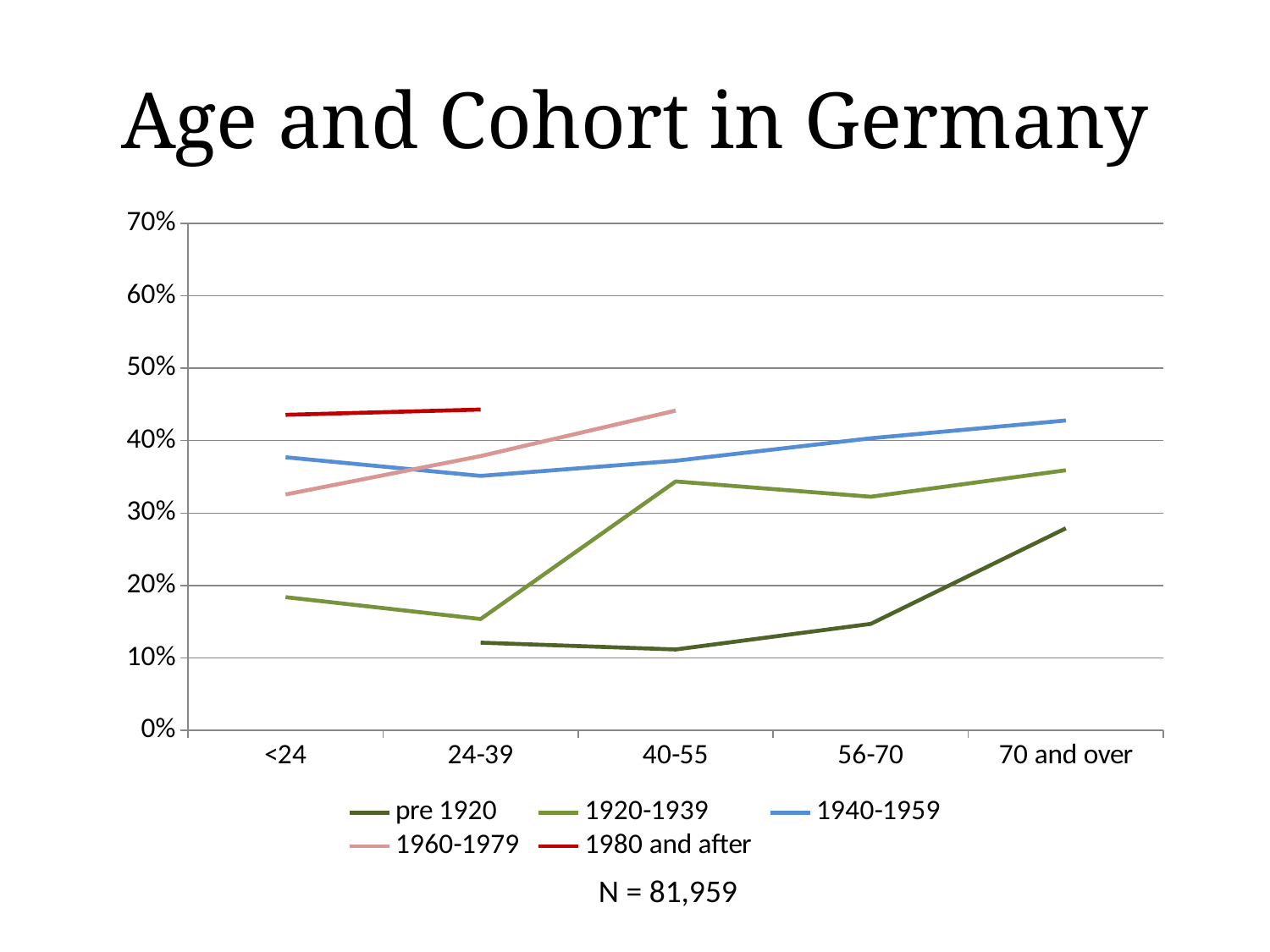
What sample size (N) is stated below the chart? N = 81,959 How many age categories are shown on the x axis? 5 What kind of chart is shown on the slide? line chart Does the pre 1920 line rise or fall from age 40-55 to age 70 and over? rise Which cohort has the highest value at age <24? 1980 and after Is the value for the pre 1920 cohort at age 40-55 greater or less than 20%? less Does the 1960-1979 line rise or fall from age <24 to age 40-55? rise Is the value for the 1940-1959 cohort at age 70 and over greater or less than 40%? greater Is the value for the 1980 and after cohort at age <24 greater or less than 40%? greater How many series does the legend list? 5 At age 24-39, which is larger: the value for the 1940-1959 cohort or the 1920-1939 cohort? 1940-1959 Which cohort has the lowest value at age 24-39? pre 1920